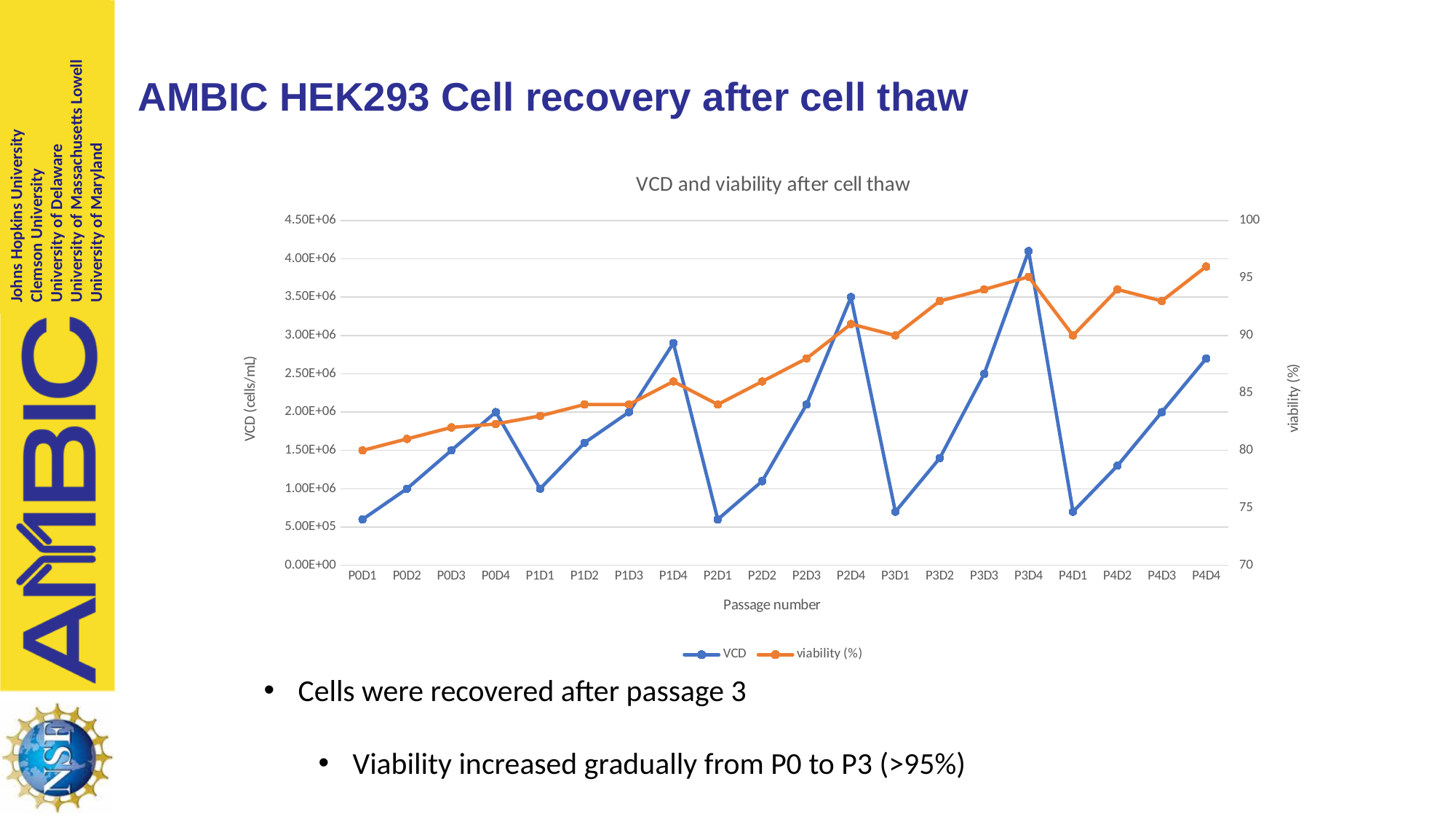
What kind of chart is shown on the slide? line chart How many passage-number categories are plotted along the x axis? 20 What is the difference between the VCD values at P2D4 and P0D2? 2.50E+06 Is the viability (%) at P4D4 greater or less than 95? greater What is the title of the chart? VCD and viability after cell thaw How many series does the legend list? 2 Which has the larger VCD value, P1D4 or P2D4? P2D4 At which passage number is viability (%) lowest? P0D1 What is the VCD value at P2D4? 3.50E+06 What is the VCD value at P0D2? 1.00E+06 Is the VCD value at P3D4 greater or less than 4.00E+06? greater At which passage number is VCD highest? P3D4